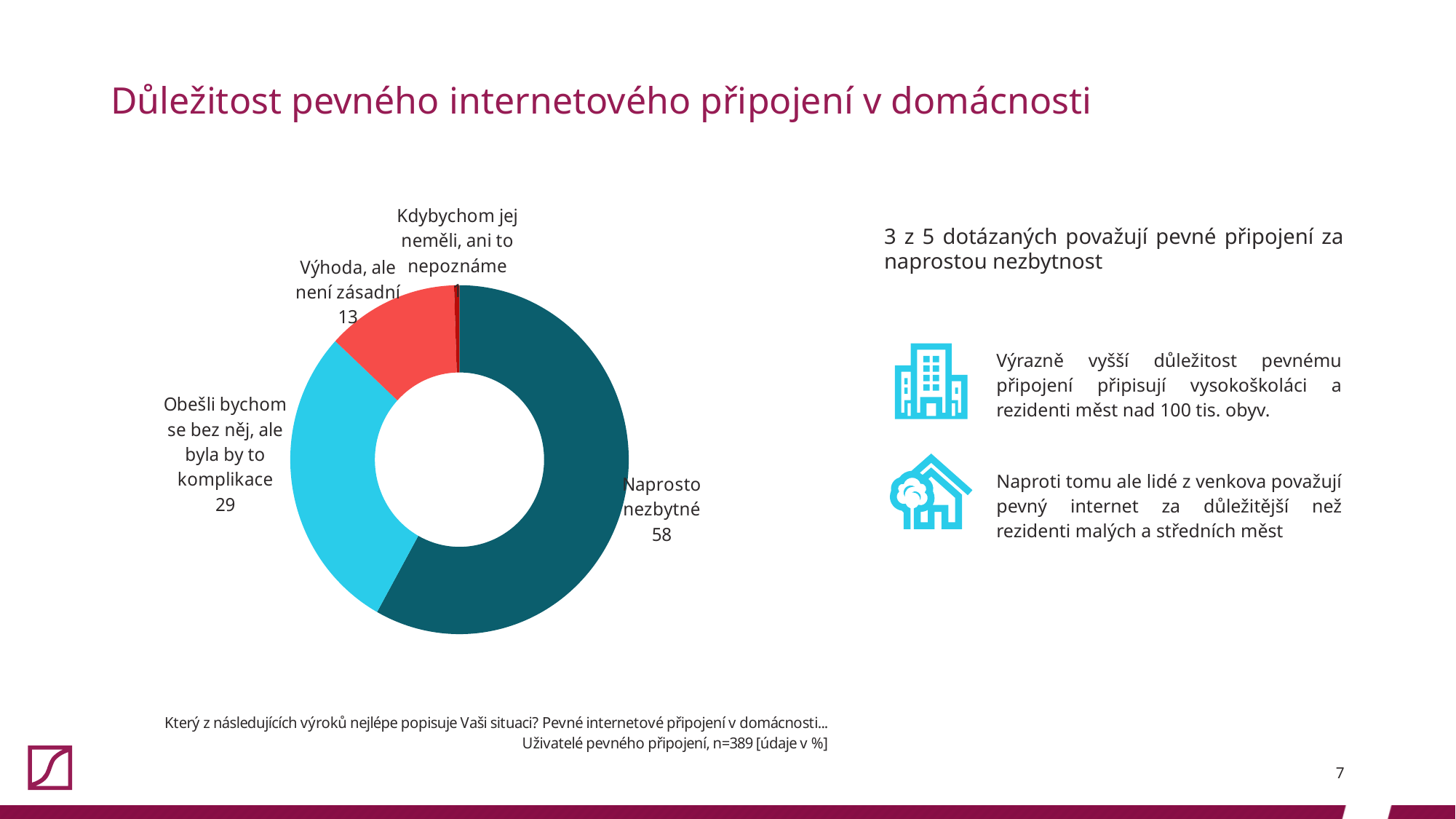
What is the difference between the values for "Obešli bychom se bez něj, ale byla by to komplikace" and "Výhoda, ale není zásadní"? 16 What share of the chart does "Naprosto nezbytné" represent, in percent? 58% What is the value for "Naprosto nezbytné"? 58 What is the title of the slide containing the chart? Důležitost pevného internetového připojení v domácnosti Which category has the largest slice of the chart? Naprosto nezbytné How many categories are shown in the chart? 4 What kind of chart is shown on the slide? Pie (donut) chart What is the difference between the values for "Naprosto nezbytné" and "Obešli bychom se bez něj, ale byla by to komplikace"? 29 What is the value for "Výhoda, ale není zásadní"? 13 Which is larger: the value for "Výhoda, ale není zásadní" or the value for "Obešli bychom se bez něj, ale byla by to komplikace"? Obešli bychom se bez něj, ale byla by to komplikace Which category has the smallest slice of the chart? Kdybychom jej neměli, ani to nepoznáme What is the value for "Obešli bychom se bez něj, ale byla by to komplikace"? 29